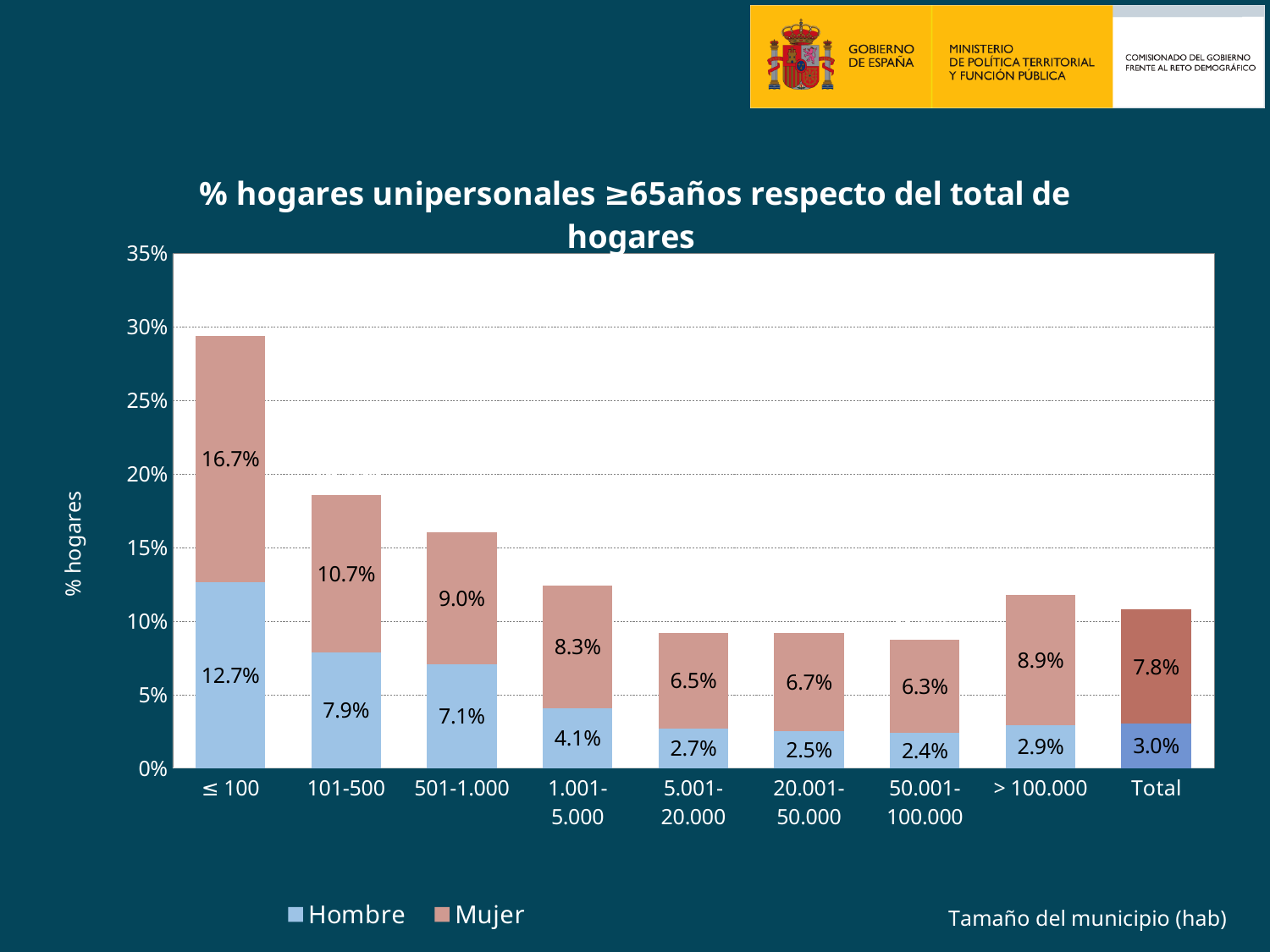
Which municipality size category has the lowest Mujer value? 50.001-100.000 What is the Hombre value for the 1.001-5.000 category? 4.1% What is the total stacked value for the 501-1.000 category? 16.1% Which municipality size category has the highest Hombre value? ≤ 100 Is the total stacked value for the ≤ 100 category greater or less than 25%? greater What is the difference between the Mujer and Hombre values for the 101-500 category? 2.8% What is the Mujer value for the Total category? 7.8% What kind of chart is shown on the slide? Stacked bar chart Which is larger, the Mujer value for > 100.000 or the Mujer value for 20.001-50.000? > 100.000 What is the Mujer value for the ≤ 100 municipality size category? 16.7% How many series does the legend list? 2 How many categories are shown on the x axis? 9